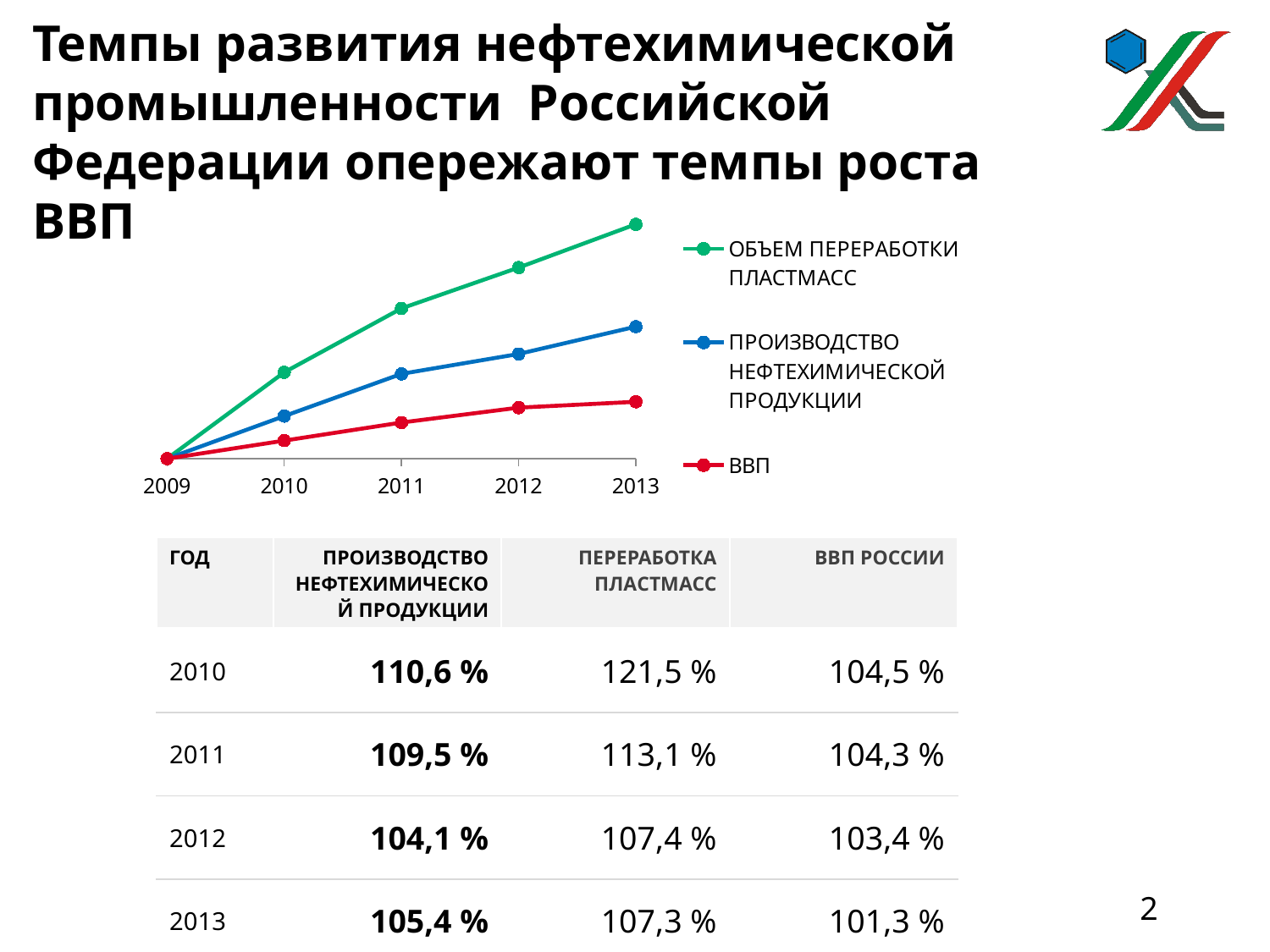
Which series is higher in 2011: ОБЪЕМ ПЕРЕРАБОТКИ ПЛАСТМАСС or ПРОИЗВОДСТВО НЕФТЕХИМИЧЕСКОЙ ПРОДУКЦИИ? ОБЪЕМ ПЕРЕРАБОТКИ ПЛАСТМАСС What is the first year shown on the x axis of the chart? 2009 Do the values of the ВВП series rise or fall from 2009 to 2013? rise Do the values of the ОБЪЕМ ПЕРЕРАБОТКИ ПЛАСТМАСС series rise or fall from 2009 to 2013? rise Which series has the highest value in 2013? ОБЪЕМ ПЕРЕРАБОТКИ ПЛАСТМАСС How many series does the chart legend list? 3 Which series is higher in 2012: ПРОИЗВОДСТВО НЕФТЕХИМИЧЕСКОЙ ПРОДУКЦИИ or ВВП? ПРОИЗВОДСТВО НЕФТЕХИМИЧЕСКОЙ ПРОДУКЦИИ Which series is drawn in green on the chart? ОБЪЕМ ПЕРЕРАБОТКИ ПЛАСТМАСС How many years are shown along the x axis of the chart? 5 What kind of chart is shown on the slide? line chart Which series has the lowest value in 2013? ВВП What colour is the line for the ВВП series? red